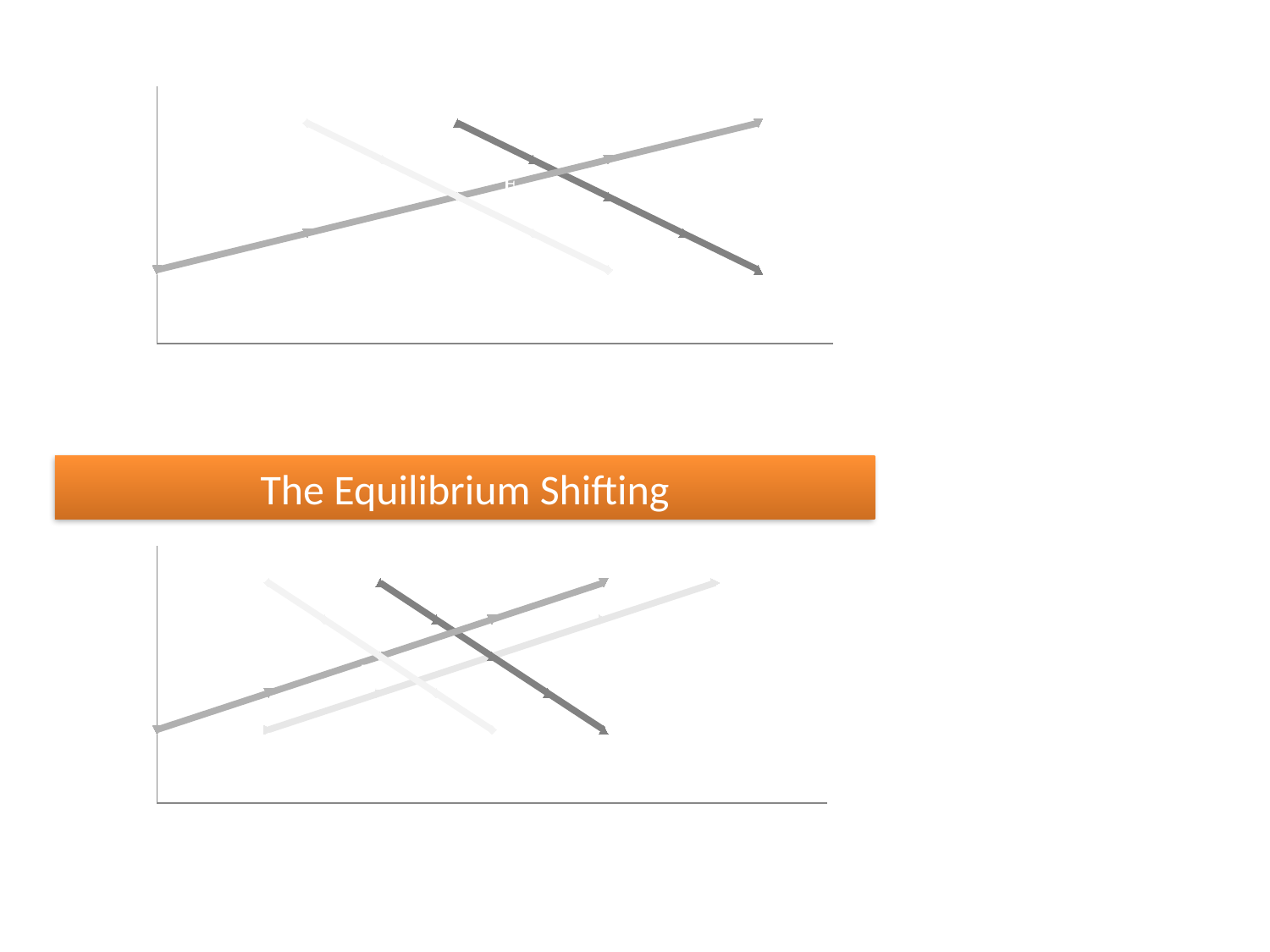
In the top chart, does the dark grey line rise or fall from left to right? fall In the bottom chart, does the dark grey line rise or fall from left to right? fall In the bottom chart, does the medium grey line that starts at the left axis rise or fall from left to right? rise What kind of chart is the bottom chart on the slide? line chart How many charts are shown on the slide? 2 What title text appears in the orange banner between the two charts? The Equilibrium Shifting How many lines are drawn in the bottom chart? 4 How many lines are drawn in the top chart? 3 What kind of chart is the top chart on the slide? line chart